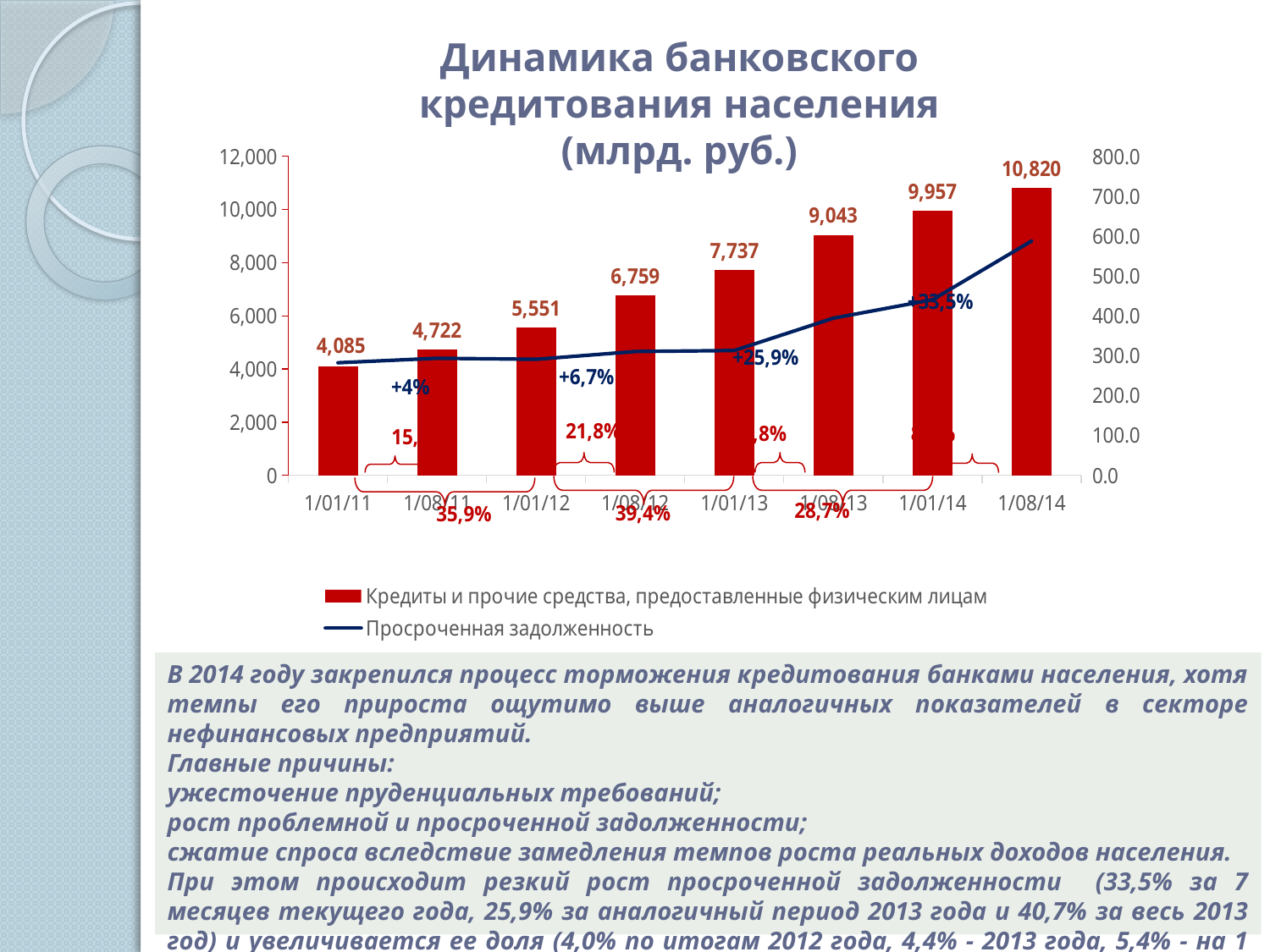
How many series does the legend list? 2 What is the value of the bar for 1/01/13? 7,737 How many dates are shown on the x axis? 8 Which date has the highest bar value? 1/08/14 Do the bar values rise or fall from 1/01/11 to 1/08/14? Rise What is the difference between the bar values for 1/08/14 and 1/01/14? 863 What is the value of the bar for 1/08/14? 10,820 What kind of chart is this? Combined bar and line chart Is the value of the Просроченная задолженность line at 1/08/14 greater or less than 500.0 on the right axis? greater What is the value of the bar for 1/01/11? 4,085 Which is larger, the bar value for 1/08/12 or for 1/01/12? 1/08/12 Which date has the lowest bar value? 1/01/11